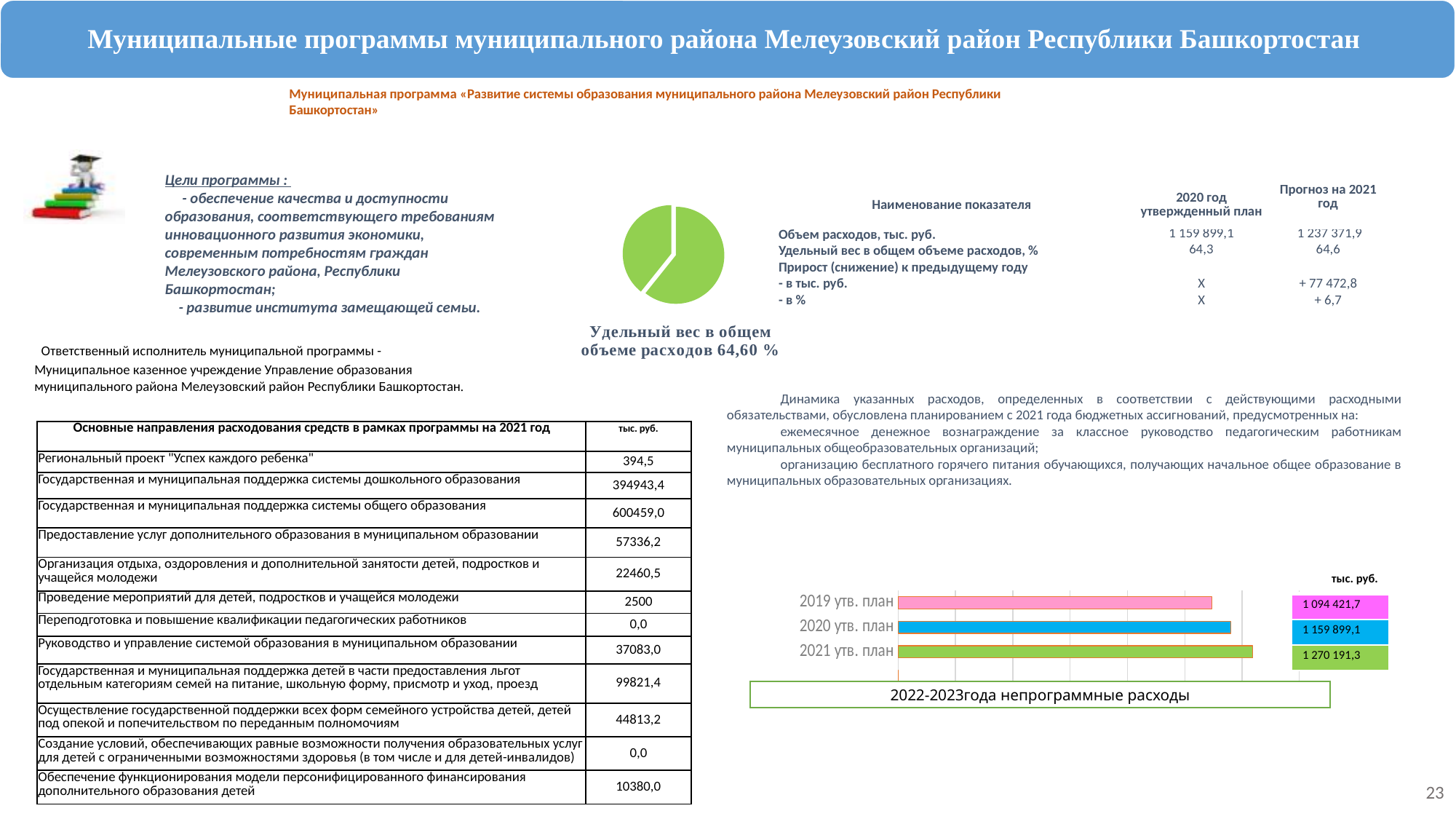
In the bar chart at the bottom right, what is the difference between the 2021 утв. план and 2020 утв. план values? 110 292,2 In the bar chart at the bottom right, which is larger: 2020 утв. план or 2019 утв. план? 2020 утв. план In the bar chart at the bottom right, what is the value for 2019 утв. план? 1 094 421,7 In the bar chart at the bottom right, which category has the lowest value? 2019 утв. план In the bar chart at the bottom right, which category has the highest value? 2021 утв. план What share of total expenditures does the larger slice of the pie chart represent, according to its caption? 64,60 % How many bars are shown in the bar chart at the bottom right? 3 In the bar chart at the bottom right, what is the difference between the 2020 утв. план and 2019 утв. план values? 65 477,4 In the bar chart at the bottom right, what is the value for 2021 утв. план? 1 270 191,3 In the bar chart at the bottom right, what is the value for 2020 утв. план? 1 159 899,1 In the bar chart at the bottom right, do the values rise or fall from 2019 to 2021? Rise What kind of chart is shown at the bottom right of the slide? Bar chart